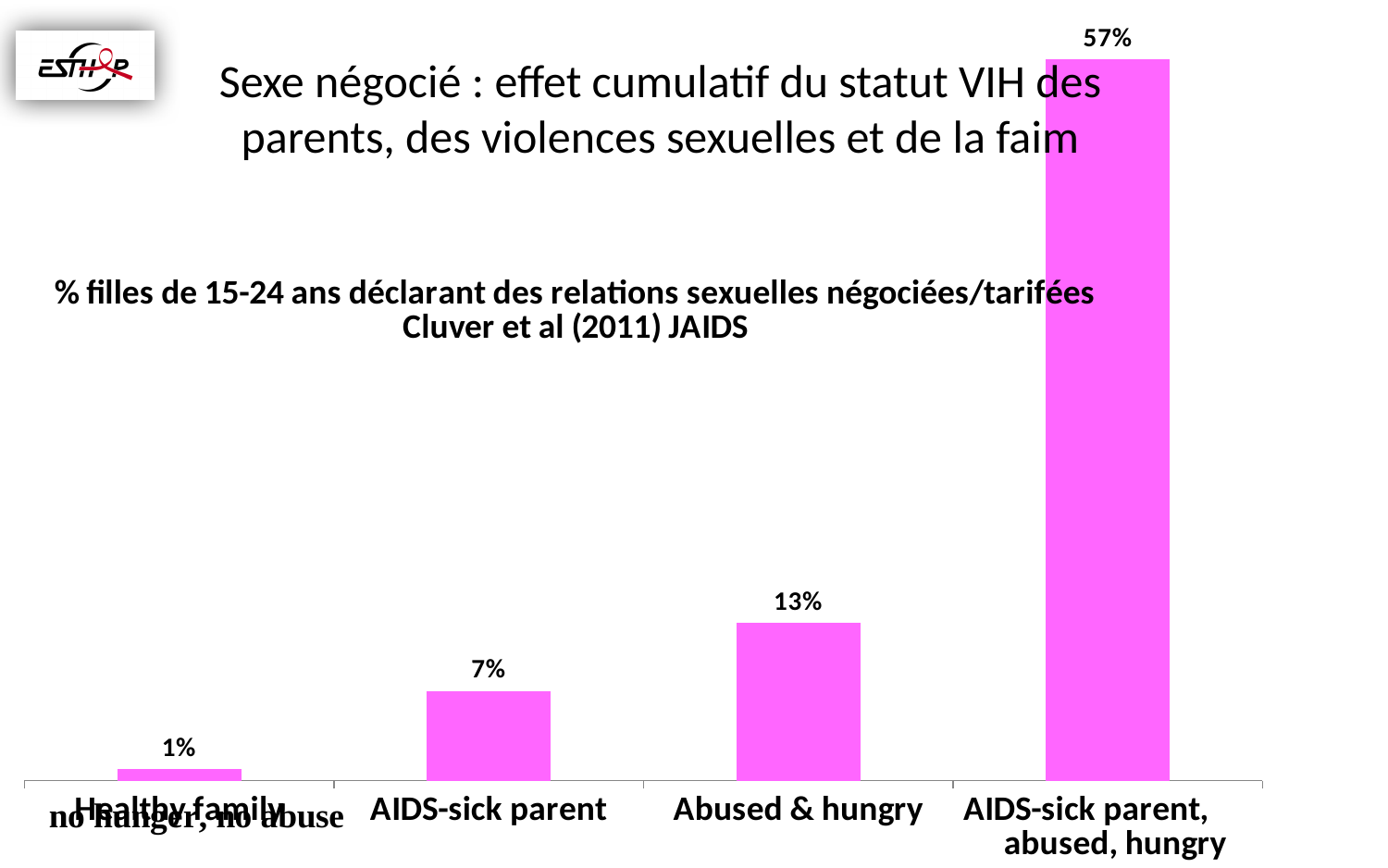
How many categories are shown in the chart? 4 Which is larger, the value for AIDS-sick parent or the value for Abused & hungry? Abused & hungry What is the value for AIDS-sick parent? 7% What is the value for Healthy family? 1% What kind of chart is shown on the slide? Bar chart What is the difference between the values for Abused & hungry and AIDS-sick parent? 6% Do the values rise or fall from left to right across the categories? Rise What is the difference between the values for AIDS-sick parent, abused, hungry and Abused & hungry? 44% Which category has the lowest value? Healthy family What is the value for Abused & hungry? 13% What is the value for AIDS-sick parent, abused, hungry? 57% Which category has the highest value? AIDS-sick parent, abused, hungry